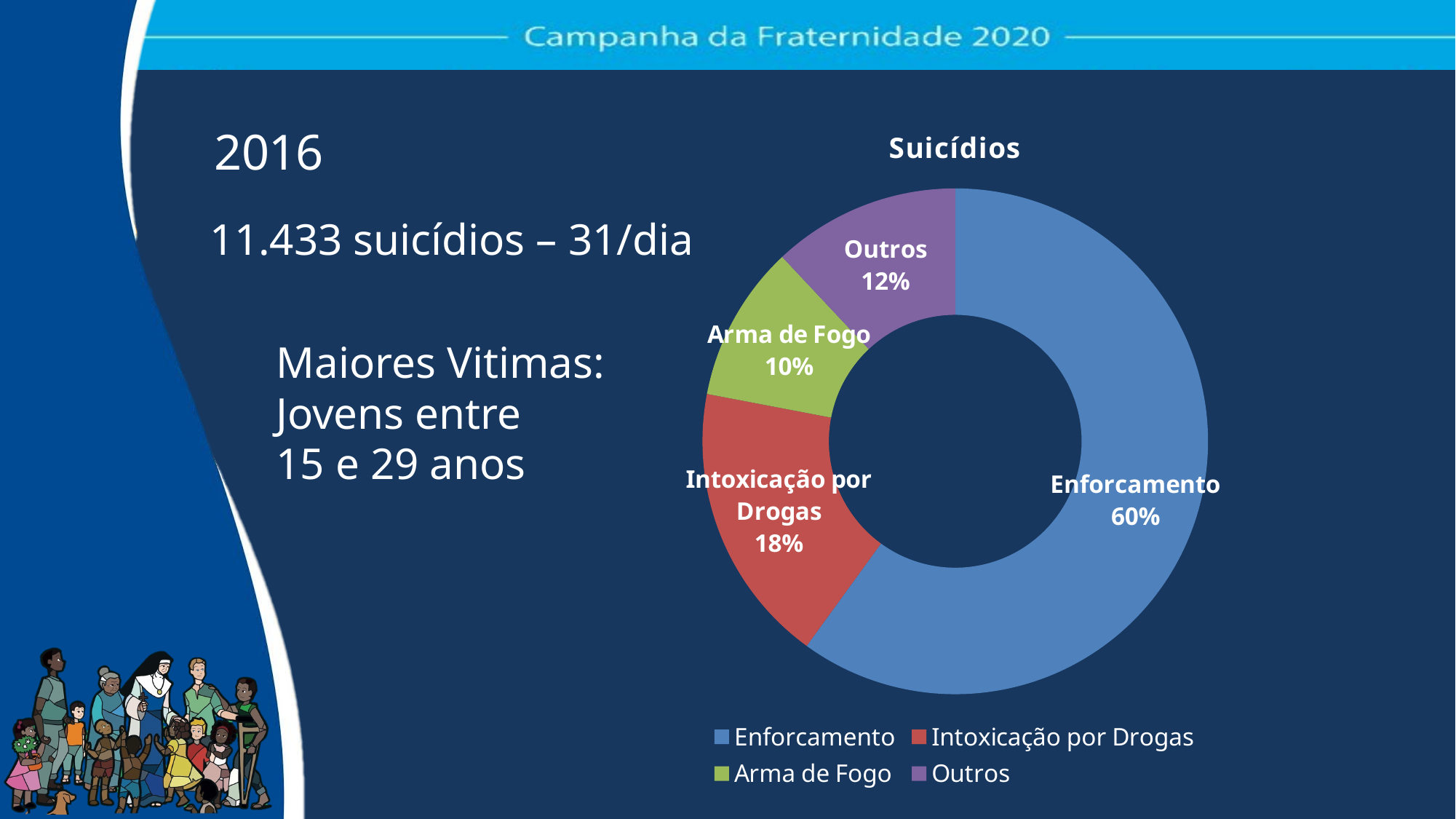
What is the difference between the shares of Enforcamento and Intoxicação por Drogas? 42% What is the value shown for Intoxicação por Drogas? 18% What is the value shown for Outros? 12% What is the difference between the shares of Outros and Arma de Fogo? 2% Which category has the largest share of the chart? Enforcamento What is the title of the chart? Suicídios What share of the pie does Enforcamento represent? 60% How many categories are shown in the chart? 4 What kind of chart is shown on the slide? Doughnut (pie) chart What is the value shown for Arma de Fogo? 10% Which is larger, the share for Outros or the share for Arma de Fogo? Outros Which category has the smallest share of the chart? Arma de Fogo